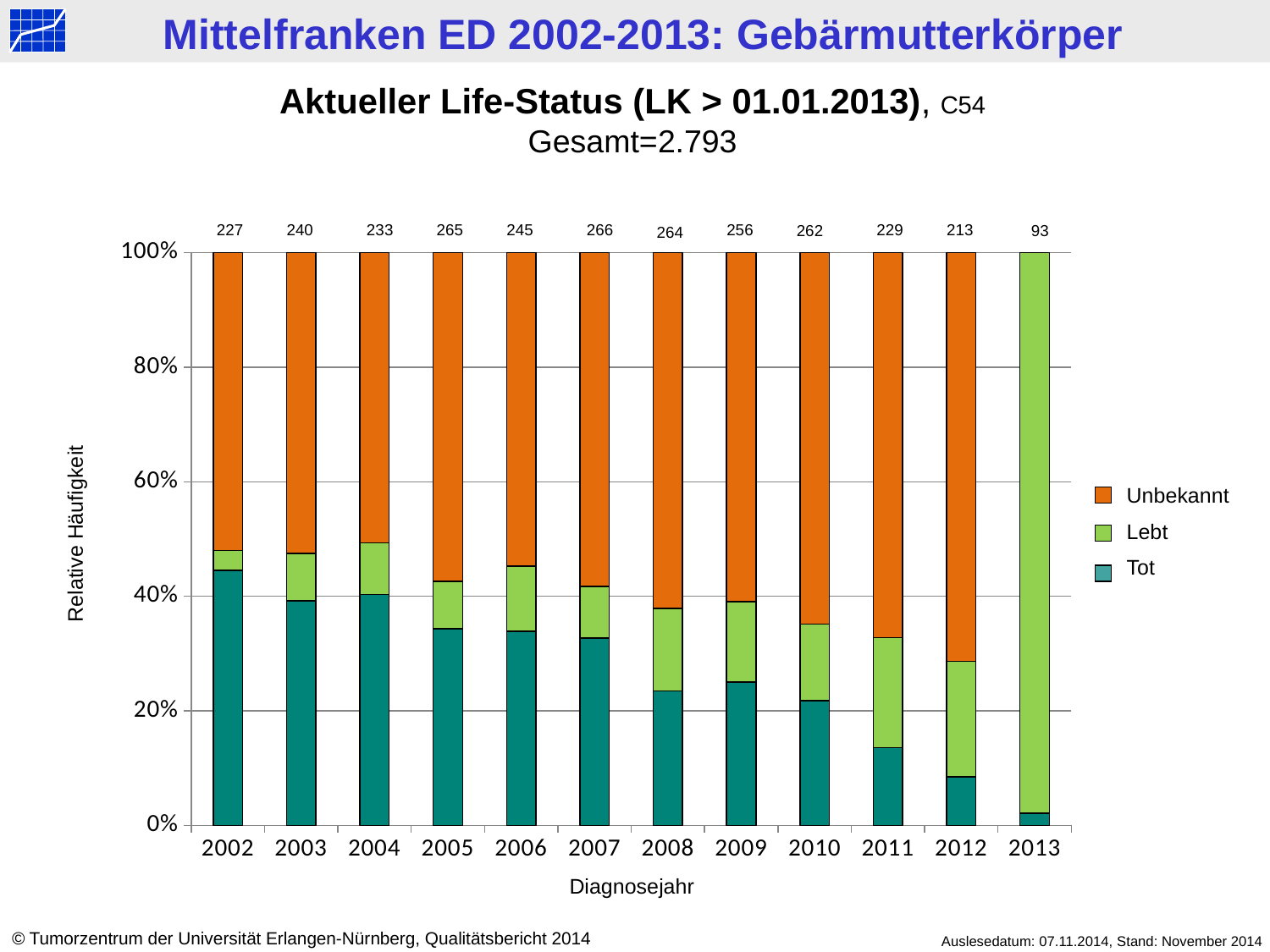
How many diagnosis years are shown on the x axis? 12 How many series does the legend list? 3 Which diagnosis year has the largest number printed above its bar? 2007 Which diagnosis year has the smallest number printed above its bar? 2013 Does the share of 'Tot' rise or fall from 2002 to 2013? fall Is the share of 'Tot' in 2002 greater or less than 40%? greater Is the number printed above the bar for 2005 larger or smaller than the one for 2011? larger Is the share of 'Tot' in 2012 greater or less than 20%? less What number is printed above the bar for 2013? 93 What number is printed above the bar for 2002? 227 What is the difference between the numbers printed above the bars for 2007 and 2013? 173 What number is printed above the bar for 2007? 266